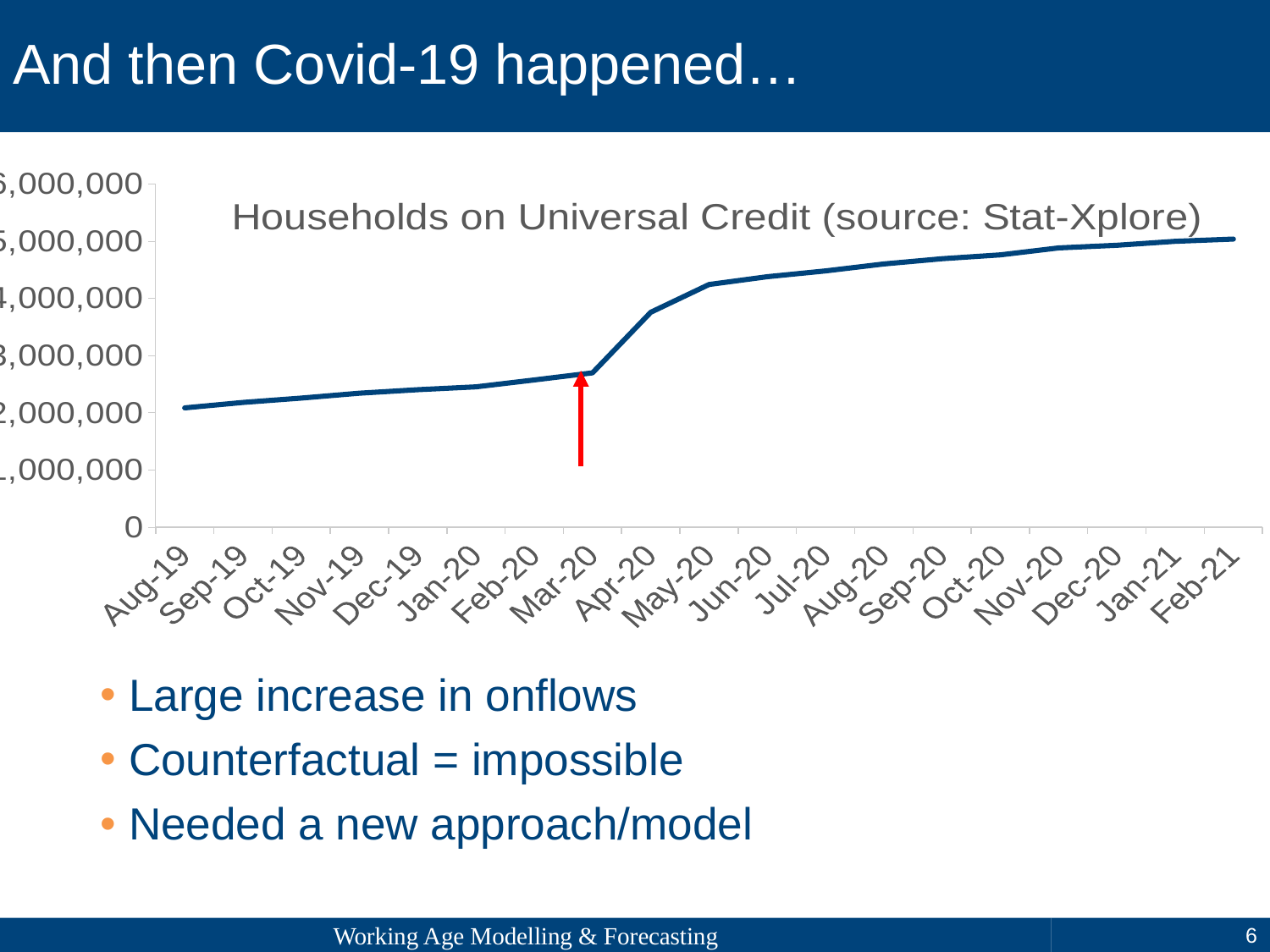
Which month has the highest number of households on Universal Credit? Feb-21 Which month has the lowest number of households on Universal Credit? Aug-19 Is the value for Mar-20 greater or less than 3,000,000? less Which is larger, the value for Apr-20 or the value for Mar-20? Apr-20 What is the title of the chart? Households on Universal Credit (source: Stat-Xplore) Which month does the red arrow on the chart point to? Mar-20 Is the value for Apr-20 greater or less than 3,000,000? greater Is the value for Dec-19 greater or less than 3,000,000? less How many months are plotted along the x axis of the chart? 19 What kind of chart is shown on the slide? line chart Do the values rise or fall from Aug-19 to Feb-21? rise